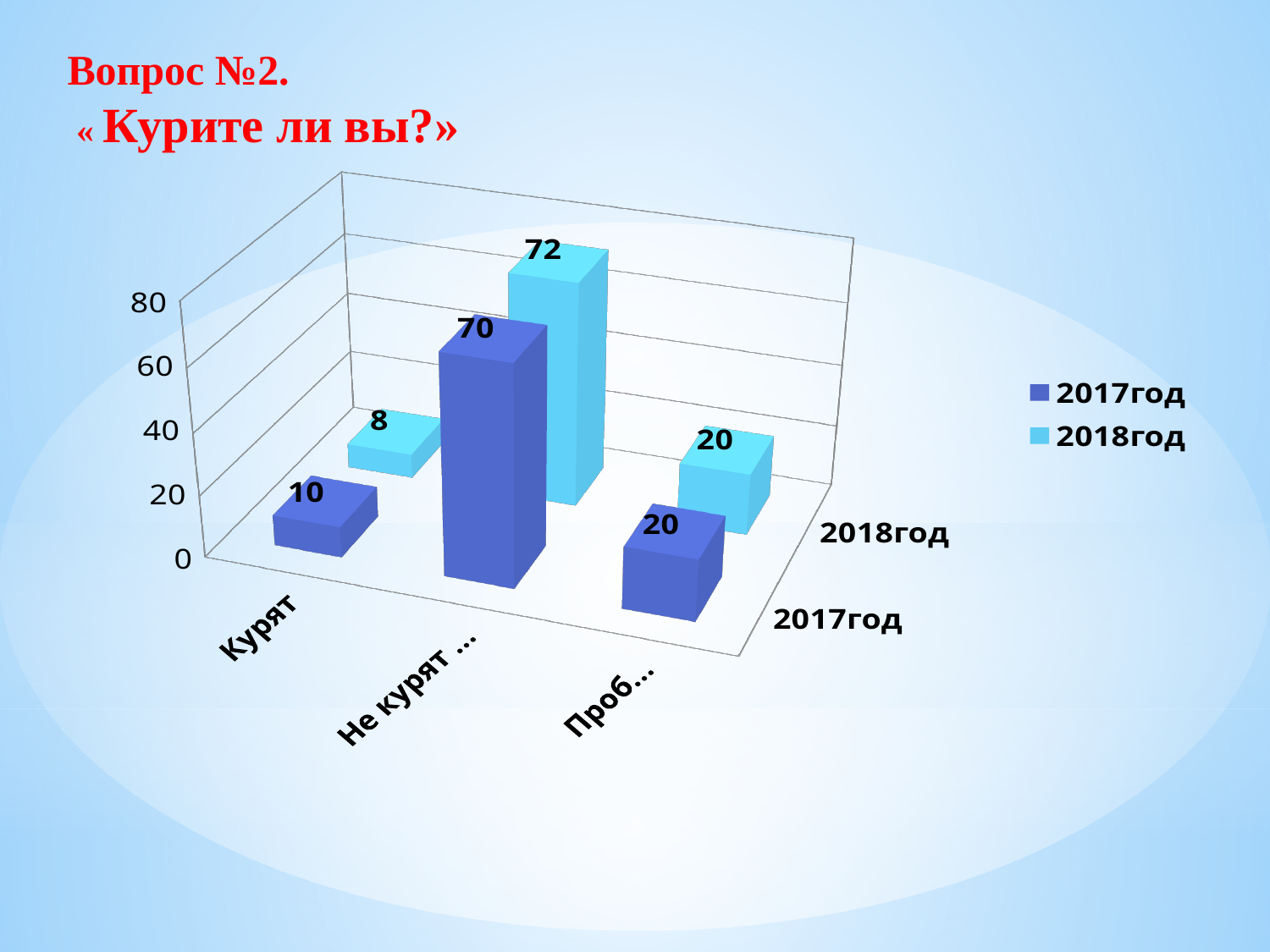
Which category has the lowest value in the 2018год series? Курят What is the value for the third category (Проб…) in the 2017год series? 20 What is the value for Курят in the 2017год series? 10 Is the 2017год value for the second category (Не курят …) greater or less than 60? greater What is the difference between the 2017год and 2018год values for Курят? 2 What kind of chart is shown on the slide? bar chart Which category has the highest value in the 2017год series? Не курят … What is the value for the second category (Не курят …) in the 2018год series? 72 Which is larger for Курят: the 2017год value or the 2018год value? 2017год What is the value for Курят in the 2018год series? 8 How many categories are shown on the x axis? 3 How many series does the legend list? 2